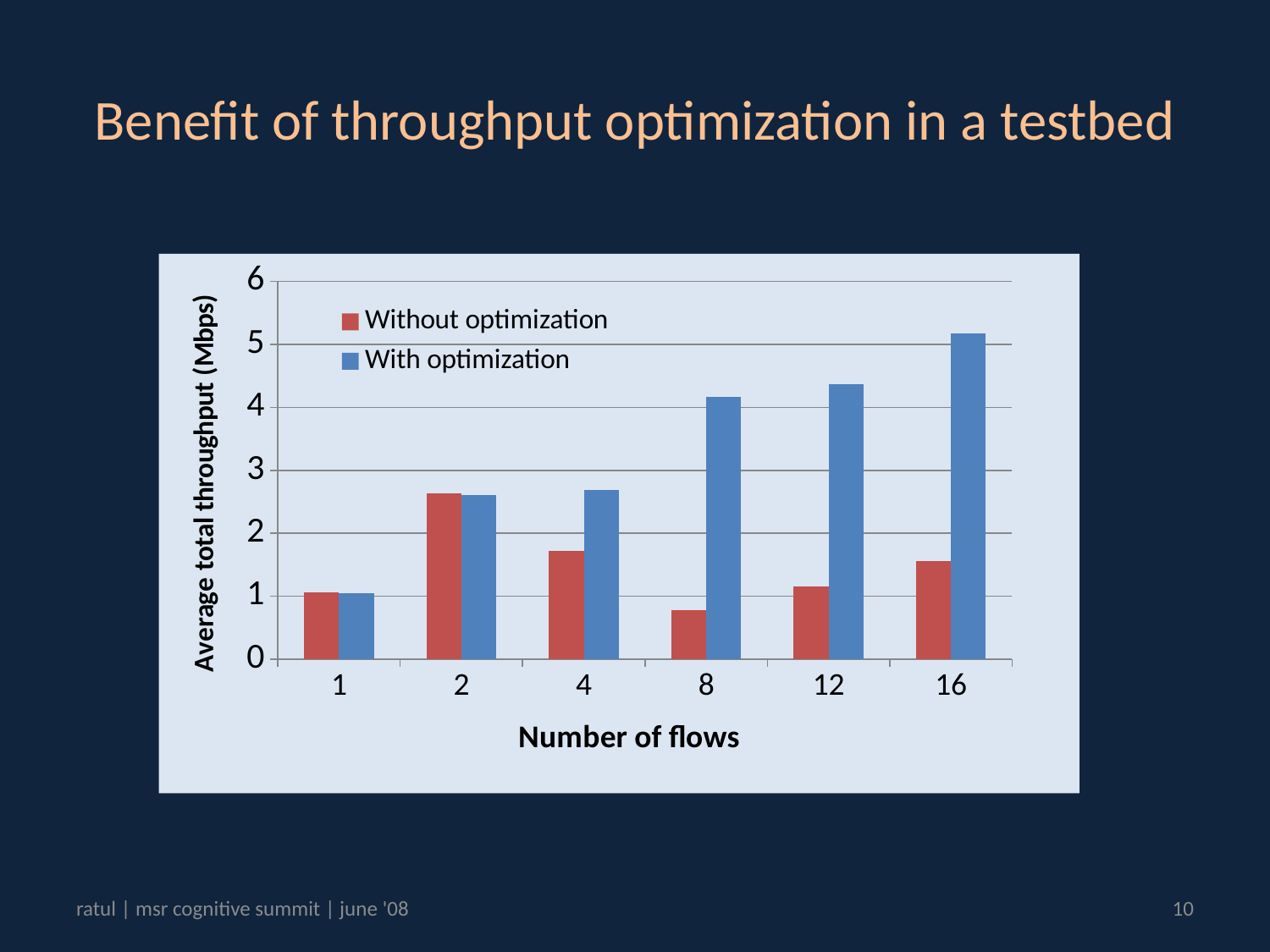
What kind of chart is shown on the slide? bar chart For which number of flows is the 'Without optimization' value highest? 2 Is the 'With optimization' value at 16 flows greater or less than 5? greater Is the 'With optimization' value at 12 flows greater or less than 4? greater Is the 'Without optimization' value at 8 flows greater or less than 1? less Do the 'With optimization' values generally rise or fall as the number of flows increases? rise How many series does the legend list? 2 For which number of flows is the 'With optimization' value highest? 16 What is the label of the y axis? Average total throughput (Mbps) For which number of flows is the 'Without optimization' value lowest? 8 How many categories (numbers of flows) are shown on the x axis? 6 At 8 flows, which series has the larger value, 'With optimization' or 'Without optimization'? With optimization